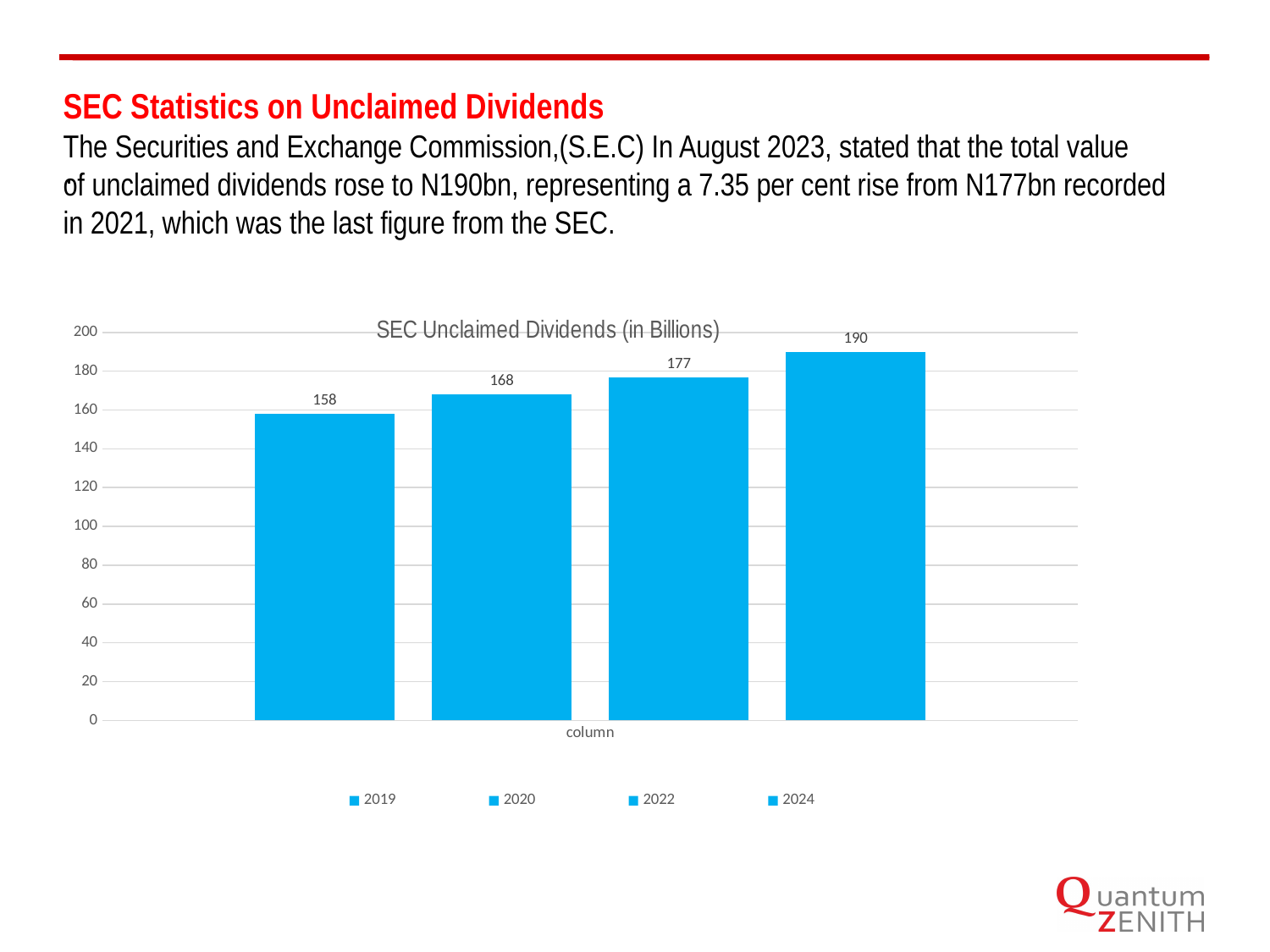
Which year has the lowest value in the SEC Unclaimed Dividends chart? 2019 Which year has the highest value in the SEC Unclaimed Dividends chart? 2024 What kind of chart is the SEC Unclaimed Dividends chart? Bar chart What is the difference between the 2022 and 2020 values in the SEC Unclaimed Dividends chart? 9 Which is larger in the SEC Unclaimed Dividends chart, the value for 2020 or the value for 2022? 2022 What is the value for 2024 in the SEC Unclaimed Dividends chart? 190 Do the values in the SEC Unclaimed Dividends chart rise or fall from 2019 to 2024? Rise What is the value for 2022 in the SEC Unclaimed Dividends chart? 177 What is the value for 2020 in the SEC Unclaimed Dividends chart? 168 How many series does the legend of the SEC Unclaimed Dividends chart list? 4 What is the value for 2019 in the SEC Unclaimed Dividends chart? 158 What is the difference between the 2024 and 2019 values in the SEC Unclaimed Dividends chart? 32